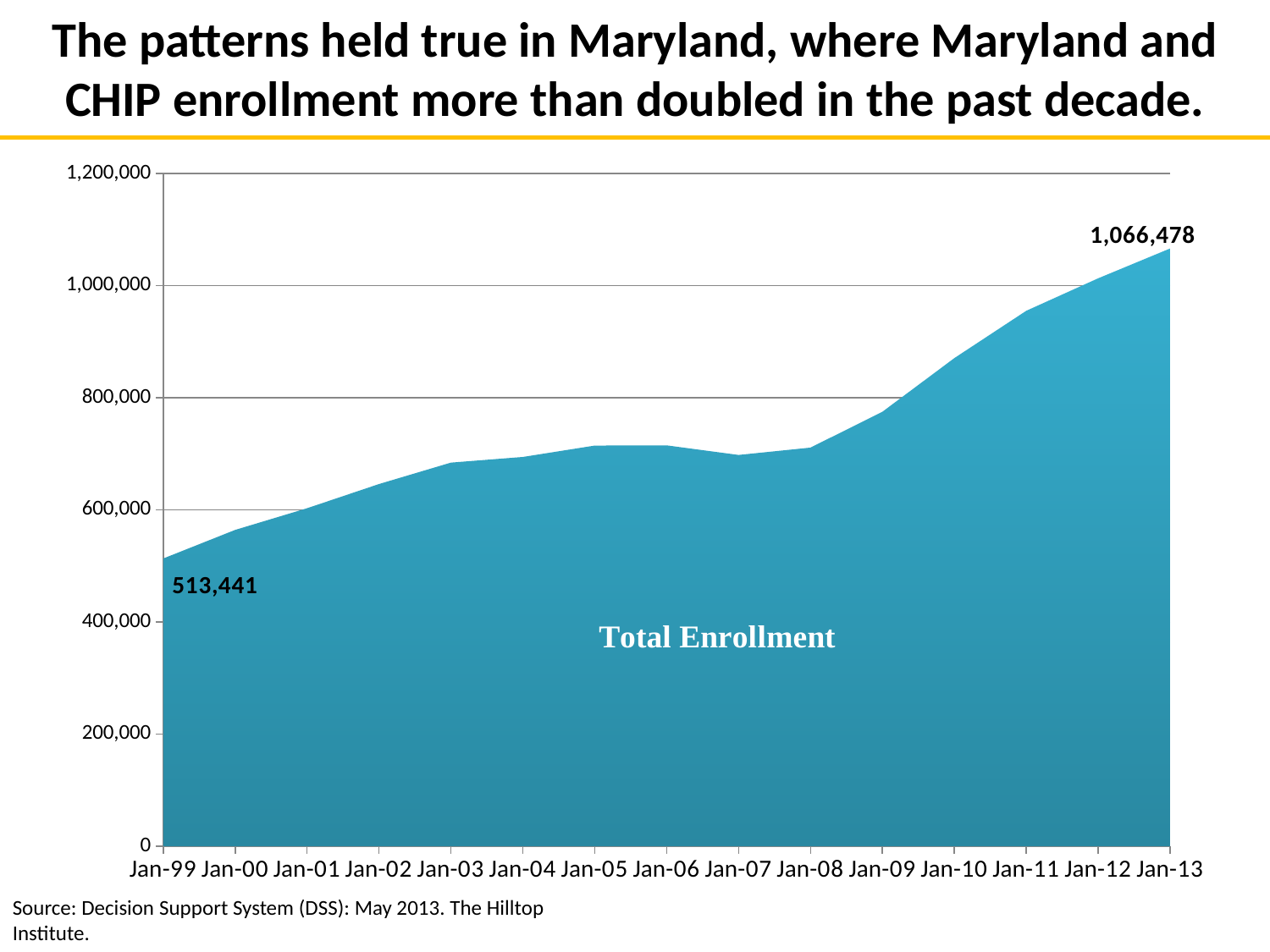
What is the total enrollment value shown for Jan-99? 513,441 What is the total enrollment value shown for Jan-13? 1,066,478 Is the value for Jan-05 greater or less than 600,000? greater Which is larger, the enrollment in Jan-99 or in Jan-13? Jan-13 What kind of chart is shown on the slide? Area chart At which date on the x axis is total enrollment highest? Jan-13 At which date on the x axis is total enrollment lowest? Jan-99 What is the difference between the enrollment in Jan-13 and the enrollment in Jan-99? 553,037 How many dates are labeled along the x axis? 15 Does total enrollment generally rise or fall from Jan-99 to Jan-13? Rise What is the name of the series labeled inside the shaded area? Total Enrollment Is the value for Jan-11 greater or less than 1,000,000? less